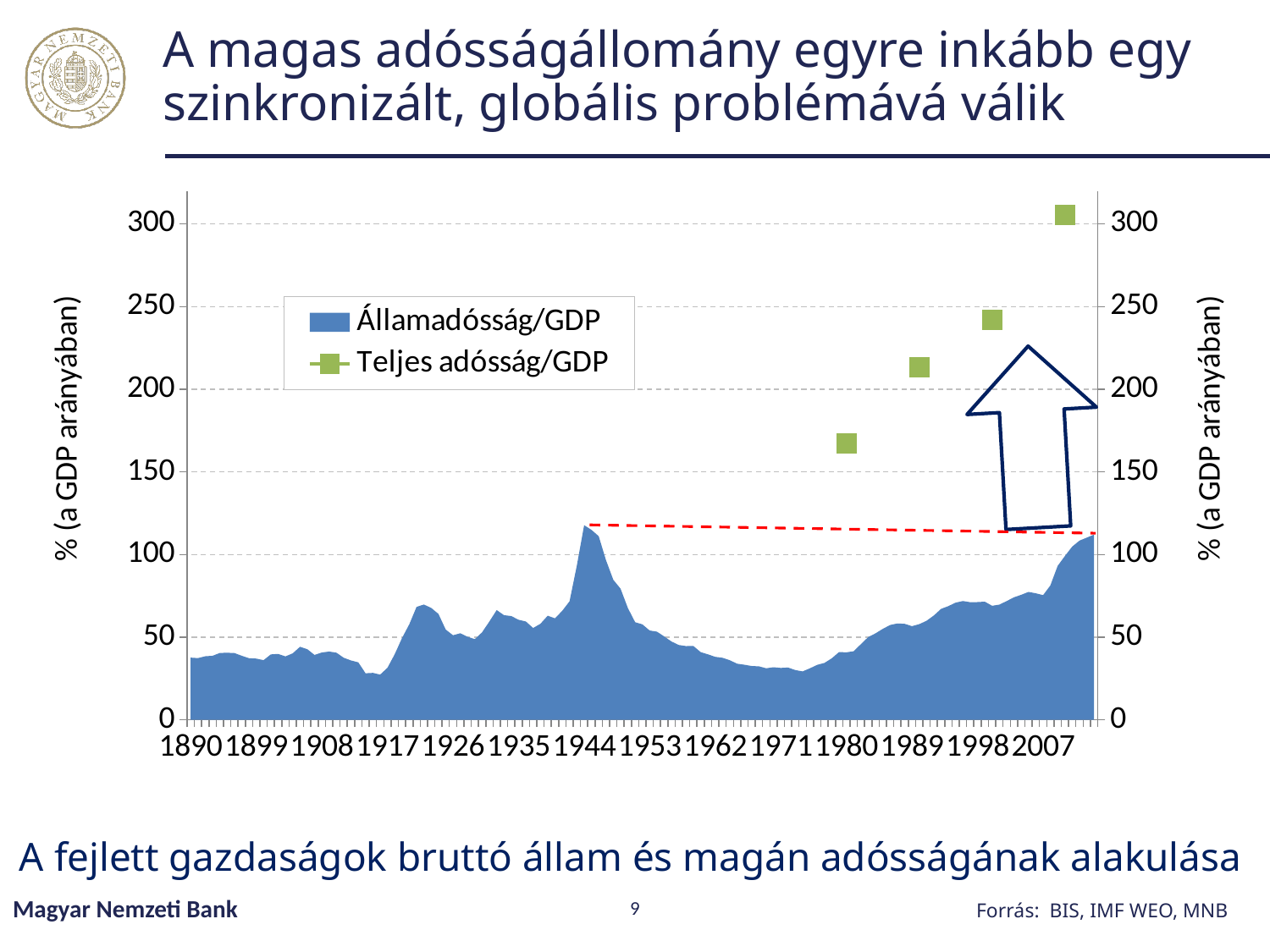
Is the first (leftmost) Teljes adósság/GDP point greater or less than 150? greater Is the value of Államadósság/GDP around 1971 greater or less than 50? less What kind of chart is used to show the Államadósság/GDP series? area chart Is the last (rightmost) Teljes adósság/GDP point greater or less than 250? greater Does Államadósság/GDP rise or fall between 1971 and 2007? rise Do the Teljes adósság/GDP points rise or fall from left to right? rise How many series does the chart legend list? 2 What are the two series named in the chart legend? Államadósság/GDP and Teljes adósság/GDP How many Teljes adósság/GDP data points are plotted on the chart? 4 What is the label on the vertical axis of the chart? % (a GDP arányában)